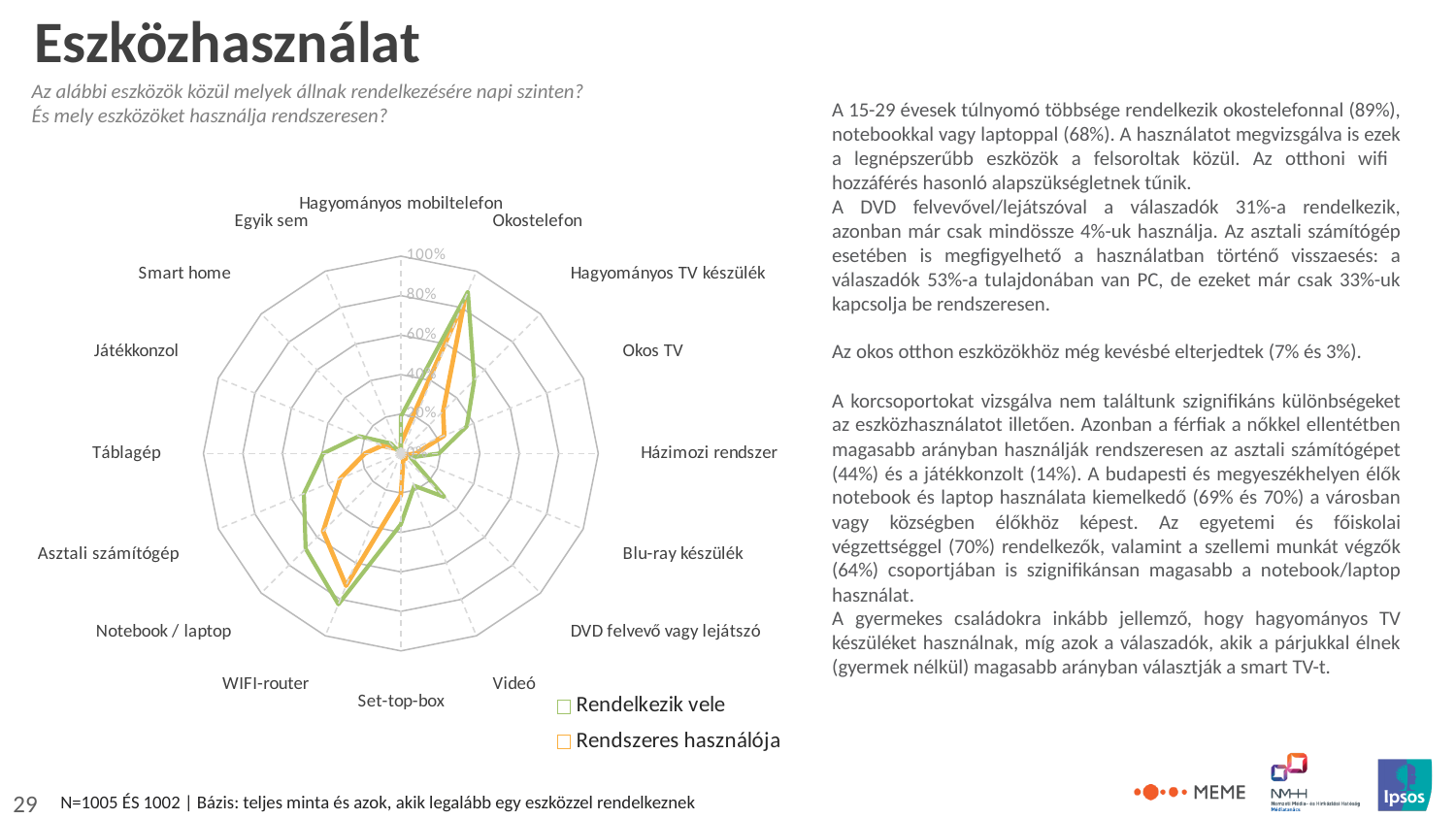
Is the 'Rendelkezik vele' value for Notebook / laptop greater or less than 60%? greater For Asztali számítógép, which series has the larger value: 'Rendelkezik vele' or 'Rendszeres használója'? Rendelkezik vele Is the 'Rendelkezik vele' value for Okostelefon greater or less than 80%? greater How many series does the chart's legend list? 2 Which category has the highest value for the 'Rendszeres használója' series? Okostelefon Is the 'Rendelkezik vele' value for Smart home greater or less than 20%? less How many device categories are plotted around the radar chart? 16 What kind of chart is shown on the slide? Radar chart Which is larger in the 'Rendelkezik vele' series: Okostelefon or Notebook / laptop? Okostelefon What are the two series named in the chart's legend? Rendelkezik vele; Rendszeres használója Which category has the highest value for the 'Rendelkezik vele' series? Okostelefon